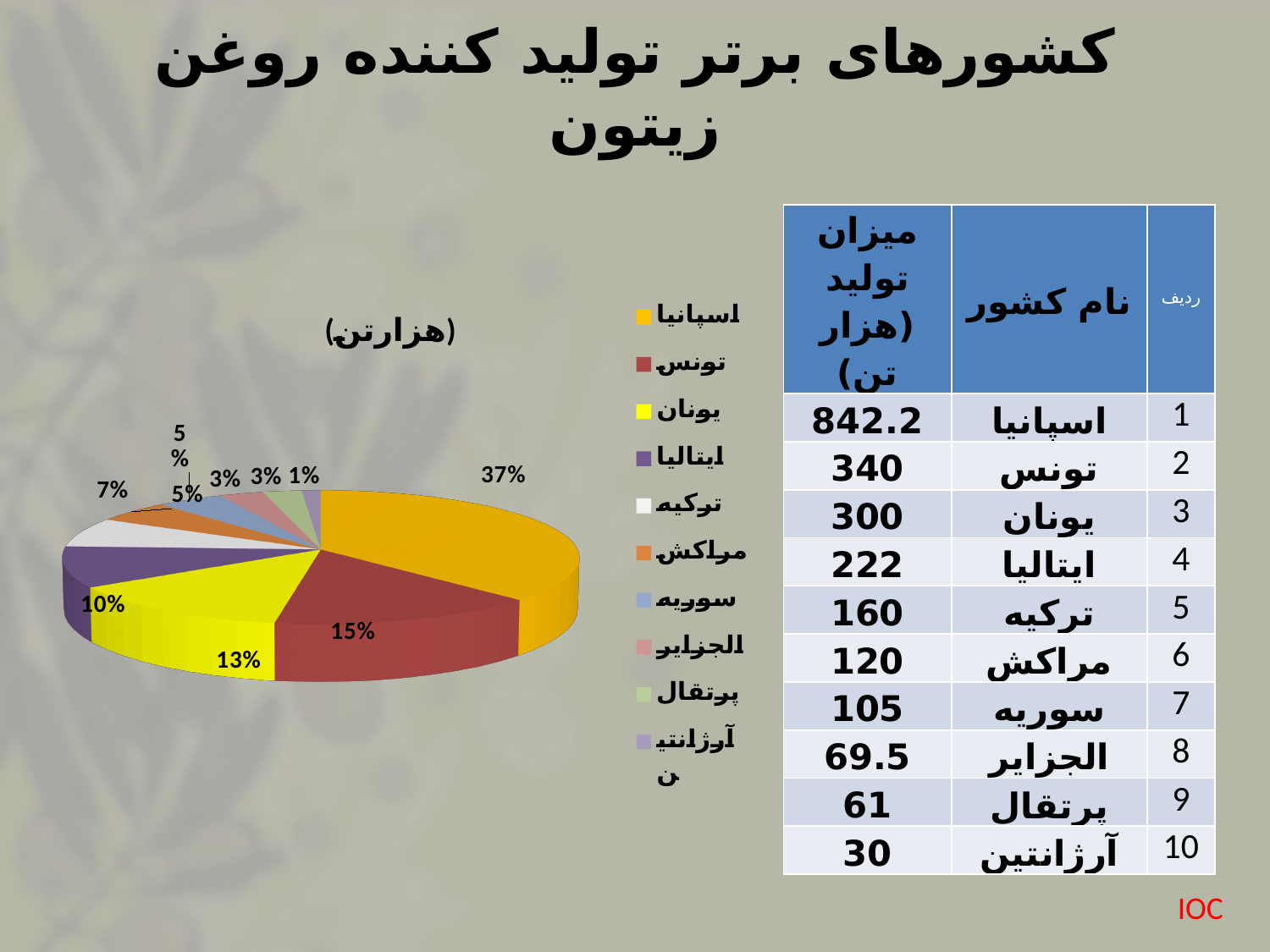
What kind of chart is shown on the slide? pie chart In the pie chart, which slice is larger: Greece (یونان) or Italy (ایتالیا)? یونان (Greece) Which country has the smallest slice in the pie chart? آرژانتین (Argentina) How many entries does the pie chart's legend list? 10 In the pie chart, what share is labelled for Greece (یونان)? 13% In the pie chart, what share is labelled for Tunisia (تونس)? 15% How many slices does the pie chart have? 10 In the pie chart, what share is labelled for Italy (ایتالیا)? 10% In the pie chart, what share is labelled for Turkey (ترکیه)? 7% In the pie chart, what share is labelled for Spain (اسپانیا)? 37% In the pie chart, how many percentage points larger is Spain's share than Tunisia's share? 22 Which country has the largest slice in the pie chart? اسپانیا (Spain)